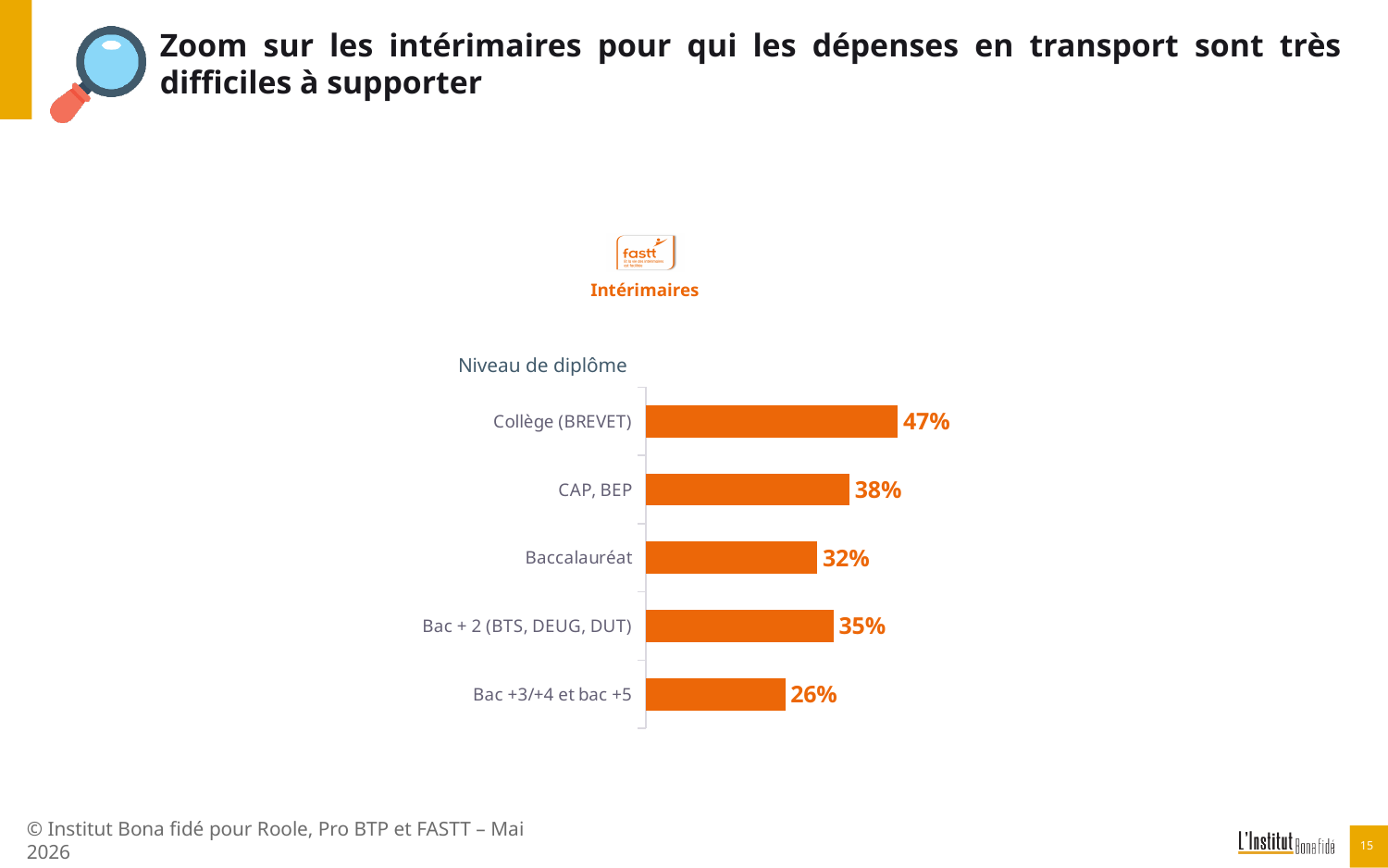
What is the value for Bac +3/+4 et bac +5? 26% Which diploma level has the highest value? Collège (BREVET) What is the value for Bac + 2 (BTS, DEUG, DUT)? 35% Which diploma level has the lowest value? Bac +3/+4 et bac +5 How many diploma levels are shown in the chart? 5 What is the value for Collège (BREVET)? 47% What is the label above the chart describing the categories? Niveau de diplôme What is the difference between the values for Collège (BREVET) and Bac +3/+4 et bac +5? 21 percentage points What is the value for CAP, BEP? 38% What kind of chart is shown on the slide? Bar chart What is the value for Baccalauréat? 32% Which is larger, the value for Baccalauréat or for Bac + 2 (BTS, DEUG, DUT)? Bac + 2 (BTS, DEUG, DUT)